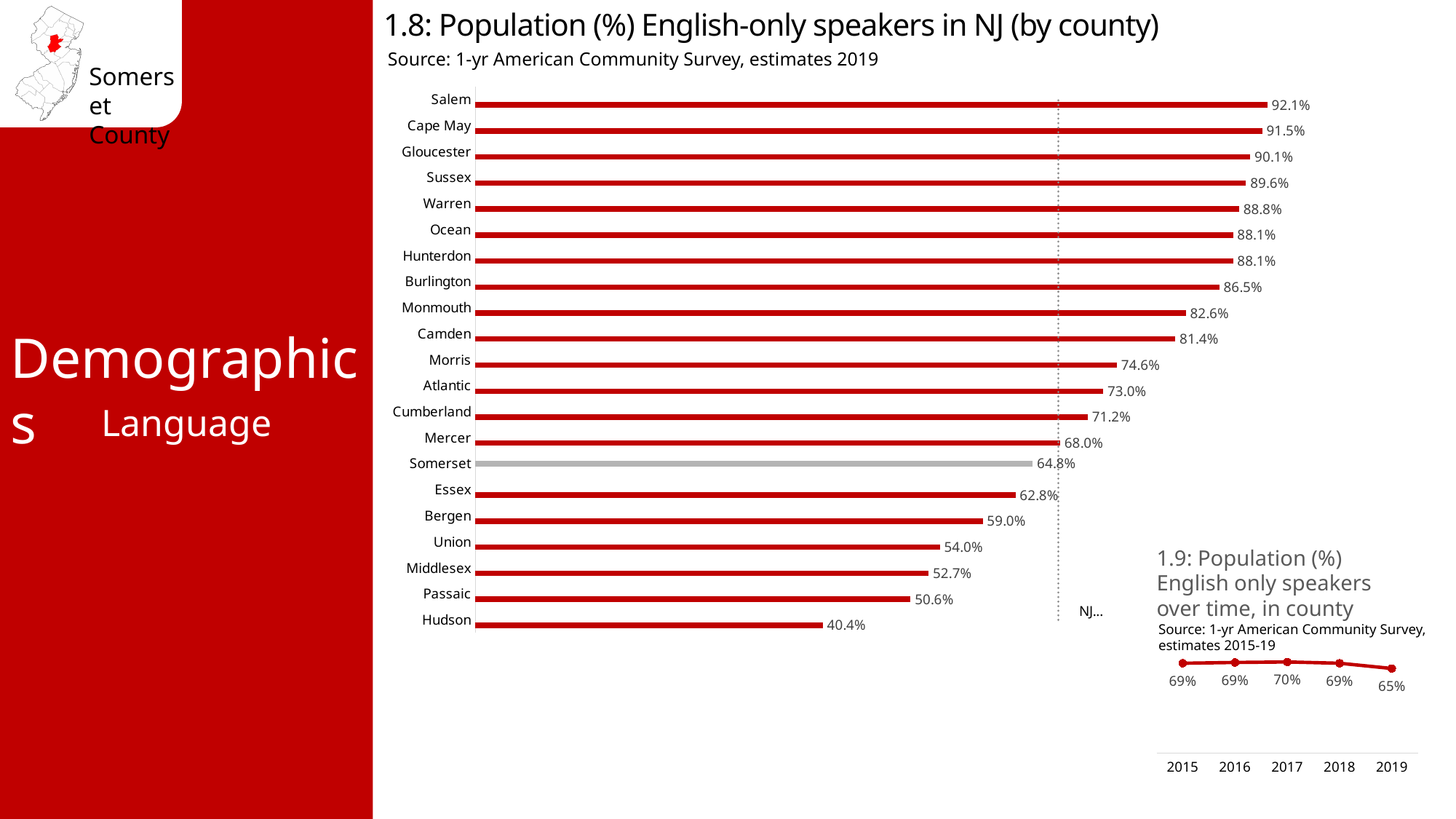
In chart 1.8, which county has the lowest percentage of English-only speakers? Hudson In chart 1.8, what is the difference between the values for Salem and Hudson? 51.7% In chart 1.8, which is larger, the value for Morris or the value for Atlantic? Morris In chart 1.8, which county has the highest percentage of English-only speakers? Salem In chart 1.9, what is the value for 2019? 65% In chart 1.8, which county's bar is coloured grey instead of red? Somerset In chart 1.8, how many counties are shown? 21 In chart 1.9, how many years are plotted? 5 What kind of chart is chart 1.8? Bar chart In chart 1.9 (Population (%) English only speakers over time, in county), what is the value for 2017? 70% In chart 1.8 (Population (%) English-only speakers in NJ by county), what is the value for Somerset? 64.8% In chart 1.8, what is the value for Hunterdon? 88.1%